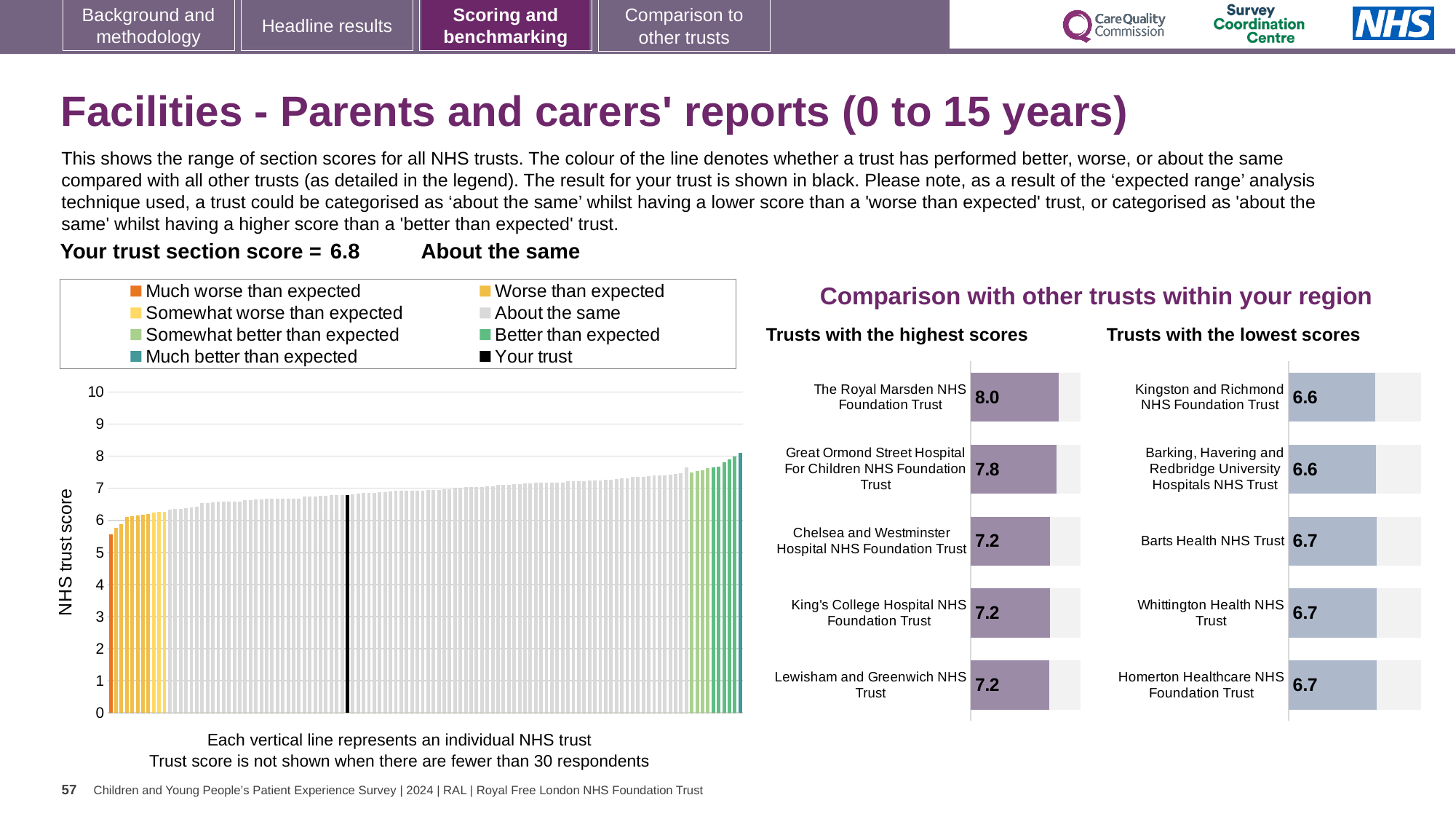
In the 'Trusts with the lowest scores' chart, what is the score for Barts Health NHS Trust? 6.7 In the 'Trusts with the highest scores' chart, what is the difference between the scores of The Royal Marsden NHS Foundation Trust and Great Ormond Street Hospital For Children NHS Foundation Trust? 0.2 In the 'Trusts with the highest scores' chart, which trust has the highest score? The Royal Marsden NHS Foundation Trust How many entries does the legend above the large chart on the left list? 8 How many trusts are shown in the 'Trusts with the lowest scores' chart? 5 In the large chart on the left, do the bar heights rise or fall from left to right? rise In the large chart on the left, is the value of the leftmost (orange) bar greater or less than 6? less In the large chart on the left, what is the label on the vertical axis? NHS trust score In the large chart on the left, is the value of the black bar (your trust) greater or less than 7? less What kind of chart is the large chart on the left showing NHS trust scores? bar chart In the 'Trusts with the highest scores' chart, what is the score for The Royal Marsden NHS Foundation Trust? 8.0 Which is larger: the score for The Royal Marsden NHS Foundation Trust in the 'Trusts with the highest scores' chart or the score for Kingston and Richmond NHS Foundation Trust in the 'Trusts with the lowest scores' chart? The Royal Marsden NHS Foundation Trust